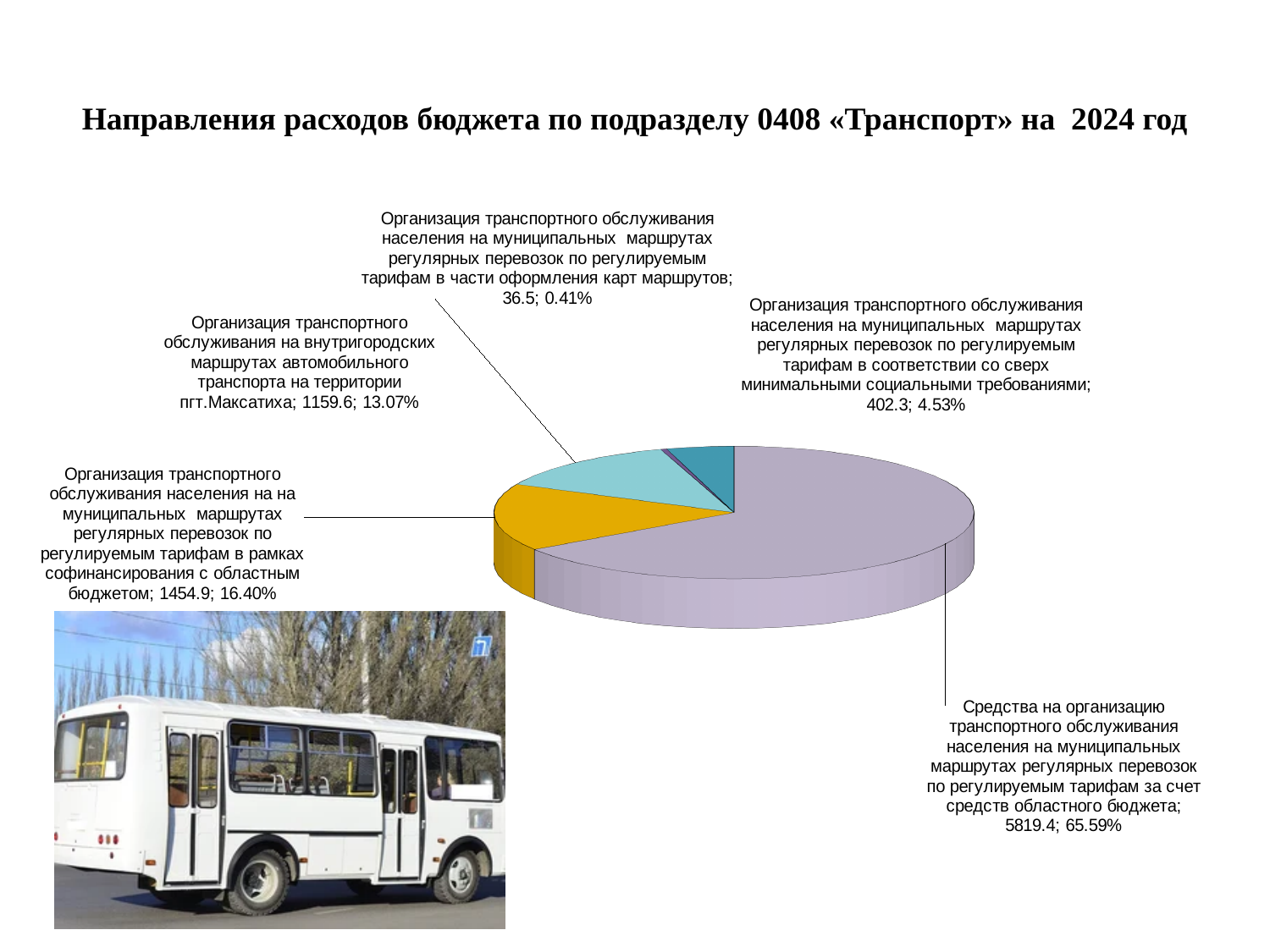
What is the title of the slide? Направления расходов бюджета по подразделу 0408 «Транспорт» на 2024 год What is the difference between the value for «... в рамках софинансирования с областным бюджетом» (1454.9) and the value for «... на территории пгт.Максатиха» (1159.6)? 295.3 What share of the pie does «Средства на организацию транспортного обслуживания населения ... за счет средств областного бюджета» take? 65.59% What percentage is shown for «Организация транспортного обслуживания ... в рамках софинансирования с областным бюджетом»? 16.40% How many slices does the pie chart have? 5 What kind of chart is shown on the slide? pie chart What is the value for «Средства на организацию транспортного обслуживания населения ... за счет средств областного бюджета»? 5819.4 What is the value for «Организация транспортного обслуживания на внутригородских маршрутах автомобильного транспорта на территории пгт.Максатиха»? 1159.6 Which category has the largest slice of the pie? Средства на организацию транспортного обслуживания населения на муниципальных маршрутах регулярных перевозок по регулируемым тарифам за счет средств областного бюджета Which category has the smallest slice of the pie? Организация транспортного обслуживания населения на муниципальных маршрутах регулярных перевозок по регулируемым тарифам в части оформления карт маршрутов Which is larger: the value for «... в соответствии со сверх минимальными социальными требованиями» or the value for «... в части оформления карт маршрутов»? Организация транспортного обслуживания ... в соответствии со сверх минимальными социальными требованиями (402.3) What is the value for «Организация транспортного обслуживания ... в части оформления карт маршрутов»? 36.5